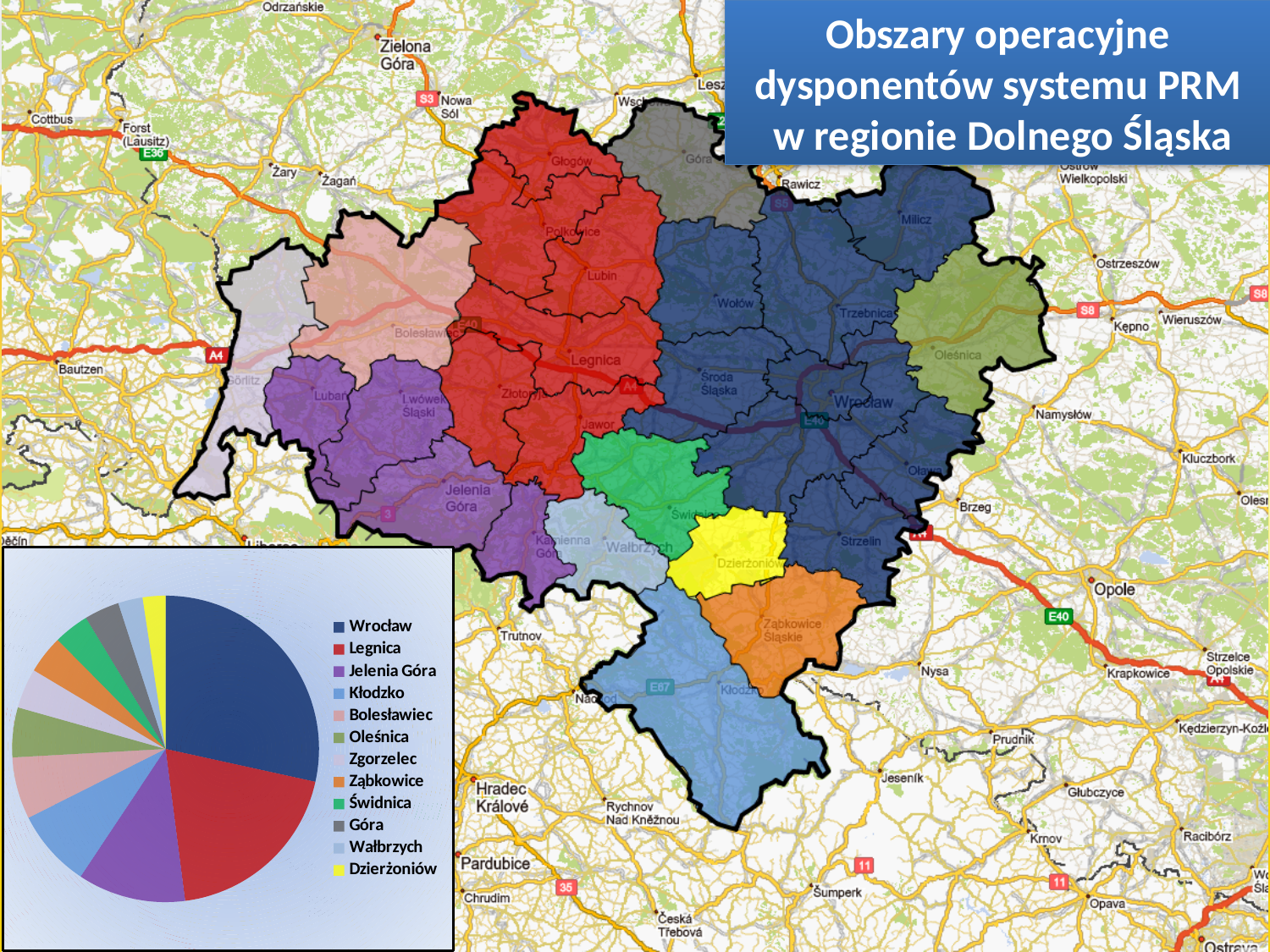
What kind of chart is shown in the bottom-left corner of the slide? pie chart Which category has the largest slice in the pie chart? Wrocław What colour represents Wrocław in the pie chart legend? dark blue Which slice is larger in the pie chart, Legnica or Jelenia Góra? Legnica What colour represents Dzierżoniów in the pie chart legend? yellow Which slice is larger in the pie chart, Wrocław or Dzierżoniów? Wrocław Which slice is larger in the pie chart, Jelenia Góra or Świdnica? Jelenia Góra How many categories does the legend of the pie chart list? 12